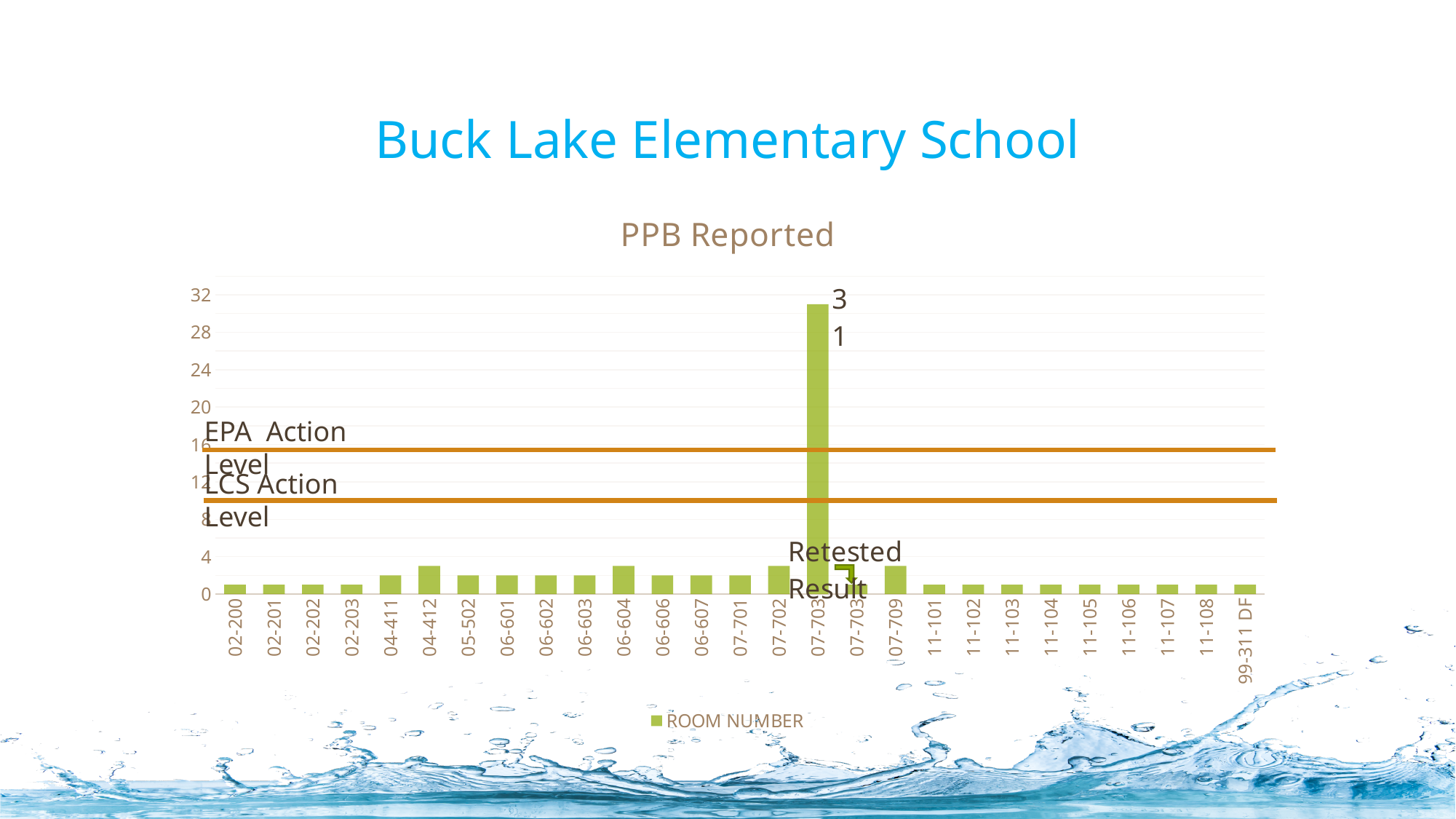
How many room categories are shown on the x axis? 27 What is the title of the chart? PPB Reported Is the value for room 11-101 greater or less than 4? less What is the PPB reported value labelled on the tallest bar, for room 07-703? 31 Which is larger, the value for room 07-703 (first bar) or the value for room 07-709? 07-703 How many series does the legend list? 1 Is the value for room 04-412 greater or less than 8? less What type of chart is shown on the slide? bar chart What is the name of the series shown in the legend? ROOM NUMBER Which room has the highest PPB reported value? 07-703 Is the value for the first 07-703 bar greater or less than 28? greater Which is larger, the value for room 04-412 or the value for room 02-200? 04-412